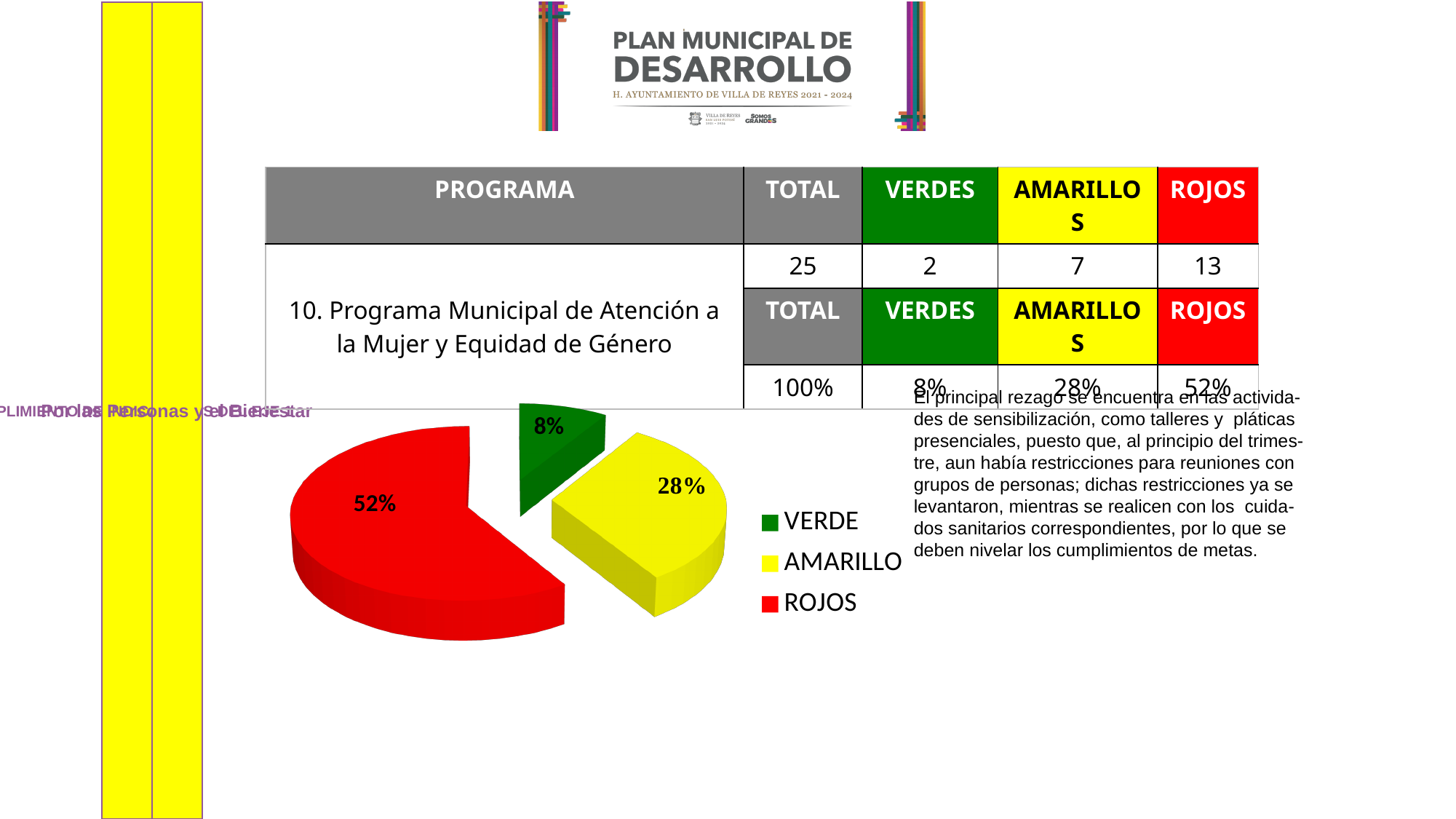
Which slice of the pie chart is the smallest? VERDE In the pie chart, which is larger, AMARILLO or VERDE? AMARILLO What is the difference in percentage points between the ROJOS and AMARILLO slices of the pie chart? 24 What percentage does the pie chart show for VERDE? 8% What percentage does the pie chart show for ROJOS? 52% What colour is the ROJOS slice in the pie chart? red What kind of chart is shown on the slide? pie chart What percentage does the pie chart show for AMARILLO? 28% How many entries does the pie chart's legend list? 3 Which slice of the pie chart is the largest? ROJOS What colour is the AMARILLO slice in the pie chart? yellow How many slices does the pie chart have? 3